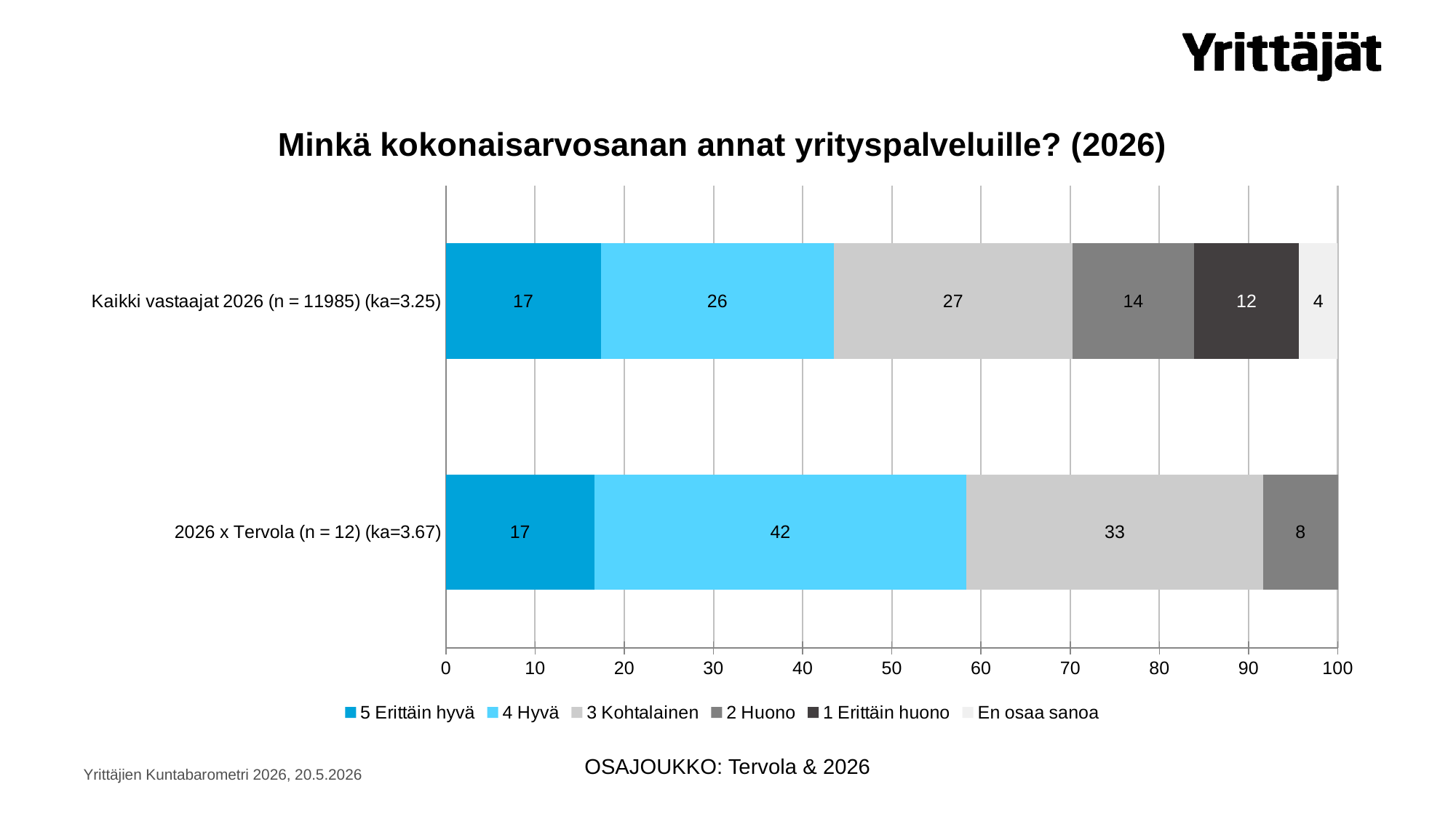
What is the value for "4 Hyvä" in the "2026 x Tervola (n = 12) (ka=3.67)" bar? 42 How many bars (categories) are shown in the chart? 2 What kind of chart is shown on the slide? Stacked bar chart Which bar has the larger value for "3 Kohtalainen": "Kaikki vastaajat 2026 (n = 11985) (ka=3.25)" or "2026 x Tervola (n = 12) (ka=3.67)"? 2026 x Tervola (n = 12) (ka=3.67) What is the value for "1 Erittäin huono" in the "Kaikki vastaajat 2026 (n = 11985) (ka=3.25)" bar? 12 What is the value for "2 Huono" in the "2026 x Tervola (n = 12) (ka=3.67)" bar? 8 Which series has the largest value in the "2026 x Tervola (n = 12) (ka=3.67)" bar? 4 Hyvä What is the value for "3 Kohtalainen" in the "Kaikki vastaajat 2026 (n = 11985) (ka=3.25)" bar? 27 What is the title of the chart? Minkä kokonaisarvosanan annat yrityspalveluille? (2026) Which series has the smallest value in the "Kaikki vastaajat 2026 (n = 11985) (ka=3.25)" bar? En osaa sanoa How many series does the legend list? 6 What is the difference between the "4 Hyvä" values for "2026 x Tervola (n = 12) (ka=3.67)" and "Kaikki vastaajat 2026 (n = 11985) (ka=3.25)"? 16